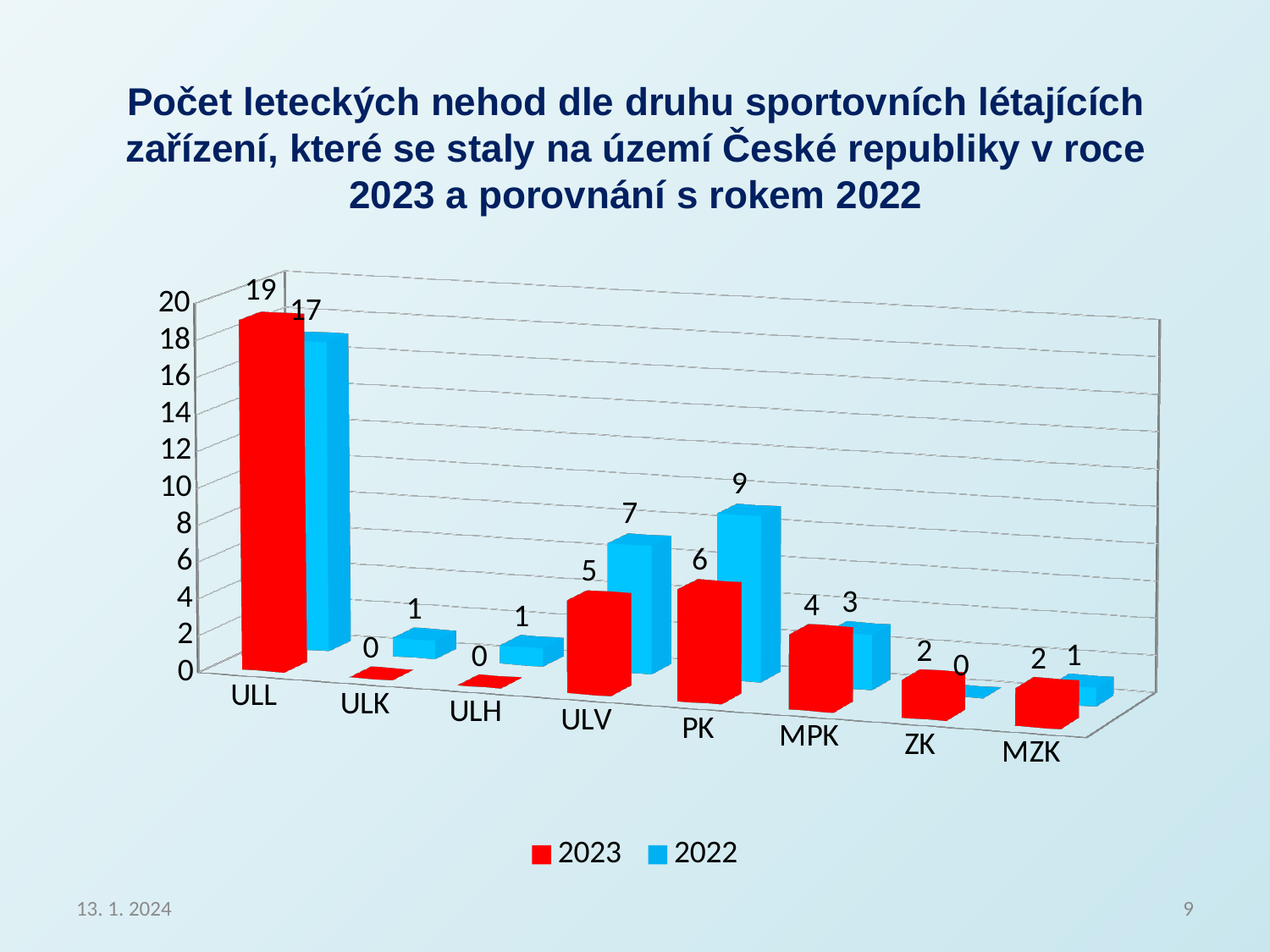
What is the value for ULL in the 2023 series? 19 What is the difference between the 2022 and 2023 values for PK? 3 Which is larger for MPK: the 2023 value or the 2022 value? 2023 What is the value for MPK in the 2023 series? 4 How many series does the legend list? 2 What kind of chart is shown on the slide? Bar chart What is the difference between the 2023 and 2022 values for ULL? 2 Which category has the highest value in the 2022 series? ULL What is the value for PK in the 2022 series? 9 Which category has the lowest value in the 2022 series? ZK How many categories are shown on the x axis? 8 Which is larger for ULV: the 2023 value or the 2022 value? 2022